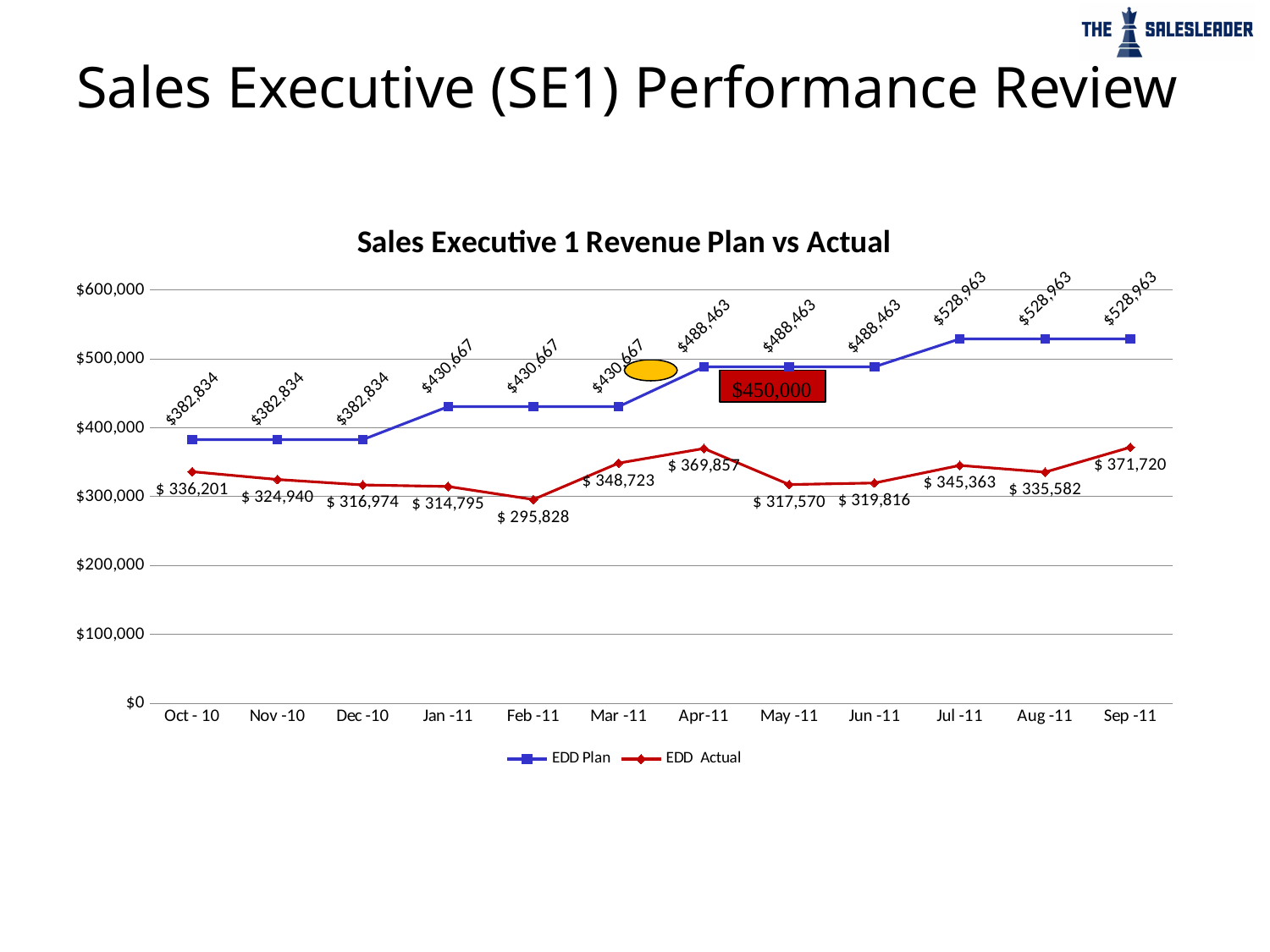
In which month is the EDD Actual value highest? Sep -11 What is the EDD Plan value for Jan -11? $430,667 How many months are shown on the x axis of the chart? 12 Is the EDD Plan value for Oct - 10 greater or less than $400,000? less By how much did EDD Actual fall from Oct - 10 to Nov -10? $11,261 In which month is the EDD Actual value lowest? Feb -11 Which month has the larger EDD Actual value, Mar -11 or Apr-11? Apr-11 Does the EDD Plan series rise or fall from Oct - 10 to Sep -11? rises What is the EDD Actual value for Feb -11? $ 295,828 How many series does the chart's legend list? 2 What kind of chart is shown on the slide? line chart What is the difference between the EDD Plan and EDD Actual values for Sep -11? $157,243